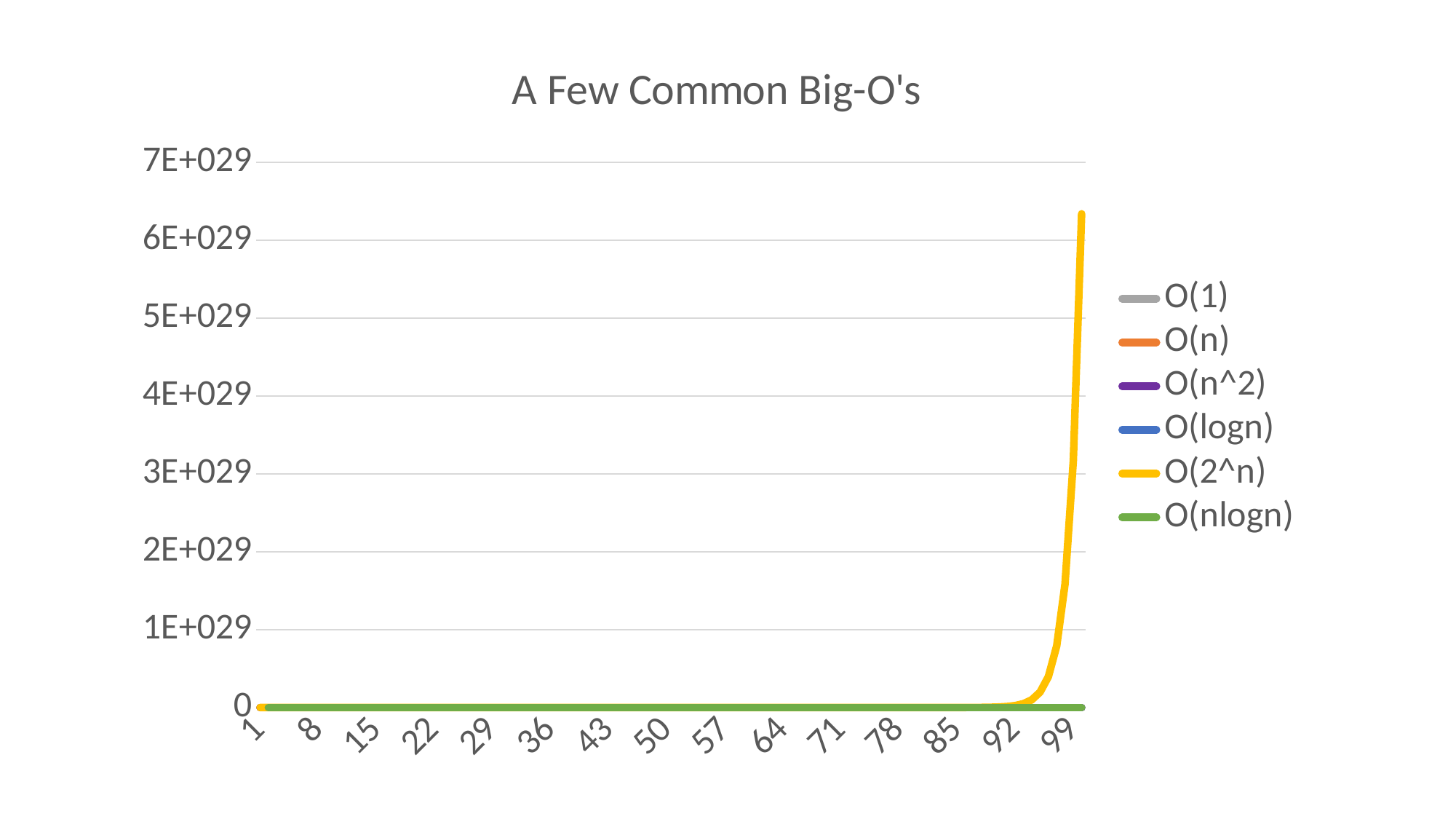
How many labels are shown along the x axis? 15 Is the value of O(2^n) at x = 92 greater or less than 1E+029? less Is the value of O(nlogn) at x = 99 greater or less than 1E+029? less Which series reaches the highest value on the chart? O(2^n) What kind of chart is shown on the slide? line chart What colour is the O(2^n) line in the legend? yellow At x = 99, which is larger, O(2^n) or O(n^2)? O(2^n) What is the highest value labelled on the y axis? 7E+029 Does the O(2^n) line rise or fall as the x axis increases? rises What is the title of the chart? A Few Common Big-O's How many series does the legend list? 6